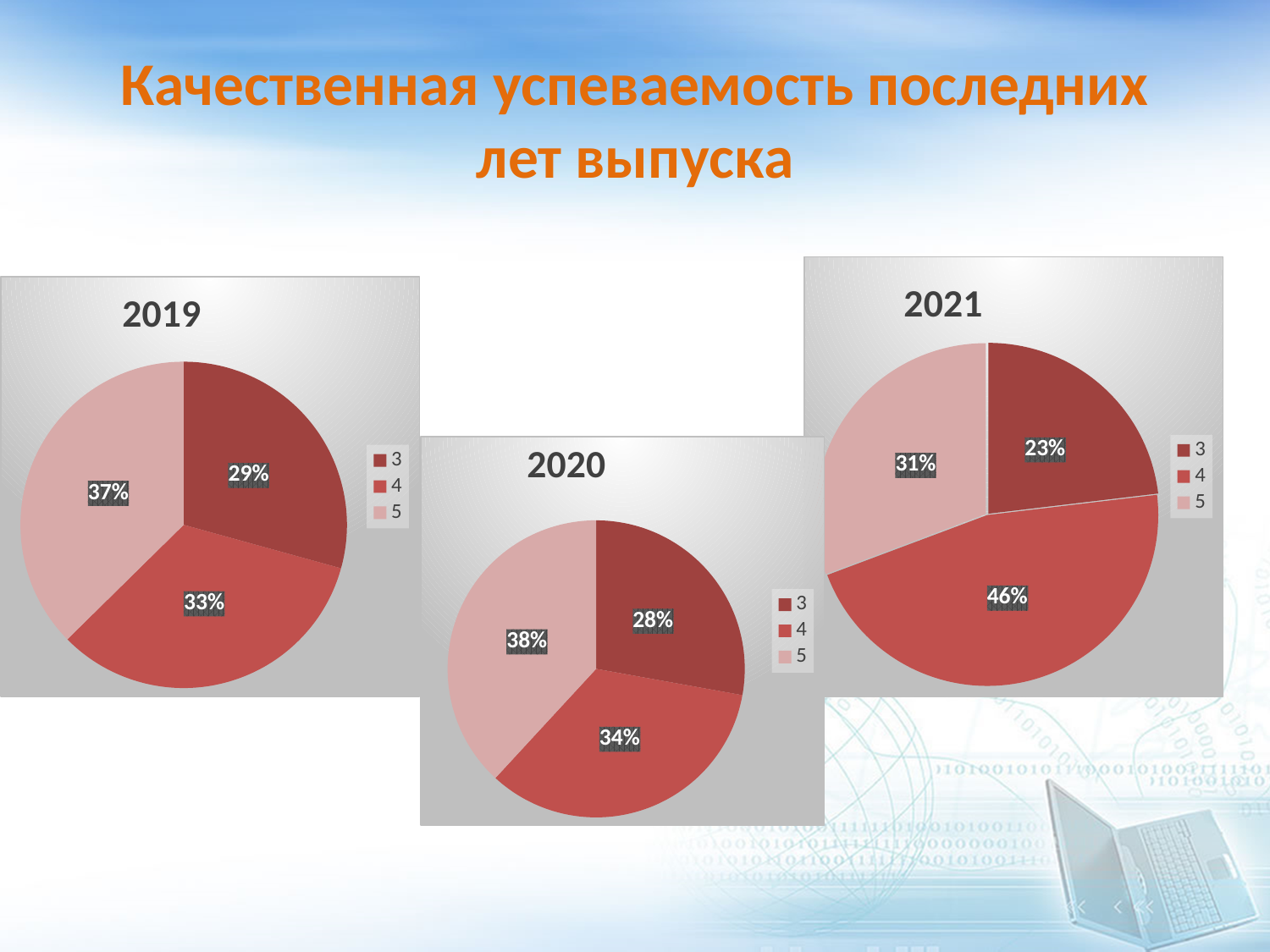
What kind of chart is the 2020 chart? pie chart In the 2020 chart, what share does category 3 have? 28% In the 2021 chart, what share does category 4 have? 46% In the 2019 chart, which category has the smallest slice? 3 In the 2019 chart, what share does category 5 have? 37% In the 2021 chart, which category has the largest slice? 4 In the 2021 chart, what is the difference between the shares of category 4 and category 3? 23% In the 2020 chart, what is the difference between the shares of category 5 and category 4? 4% How many slices does the 2021 chart have? 3 How many entries does the legend of the 2019 chart list? 3 In the 2020 chart, which category has the largest slice? 5 In the 2019 chart, which is larger: the share of category 4 or the share of category 3? 4